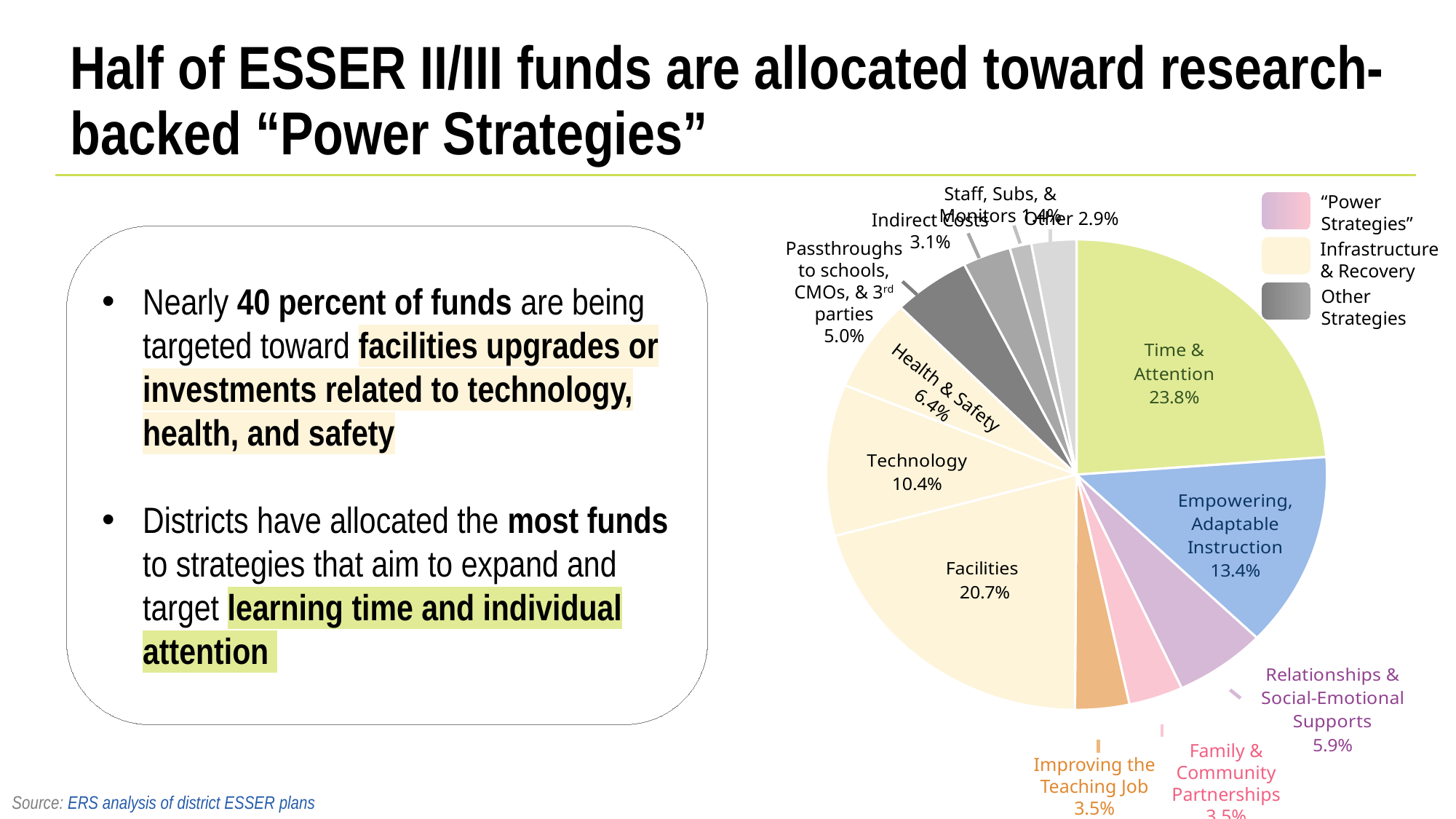
Which category receives the largest share of funds in the pie chart? Time & Attention What is the difference in percentage points between Empowering, Adaptable Instruction and Relationships & Social-Emotional Supports? 7.5 percentage points How many groups does the legend of the pie chart list? 3 What kind of chart is shown on the slide? Pie chart What share of funds is allocated to Passthroughs to schools, CMOs, & 3rd parties? 5.0% What share of funds is allocated to Time & Attention? 23.8% Which receives a larger share of funds, Technology or Health & Safety? Technology What is the difference in percentage points between Time & Attention and Facilities? 3.1 percentage points What share of funds is allocated to Empowering, Adaptable Instruction? 13.4% What colour does the legend use for "Other Strategies"? Grey What share of funds is allocated to Facilities? 20.7% What share of funds is allocated to Technology? 10.4%